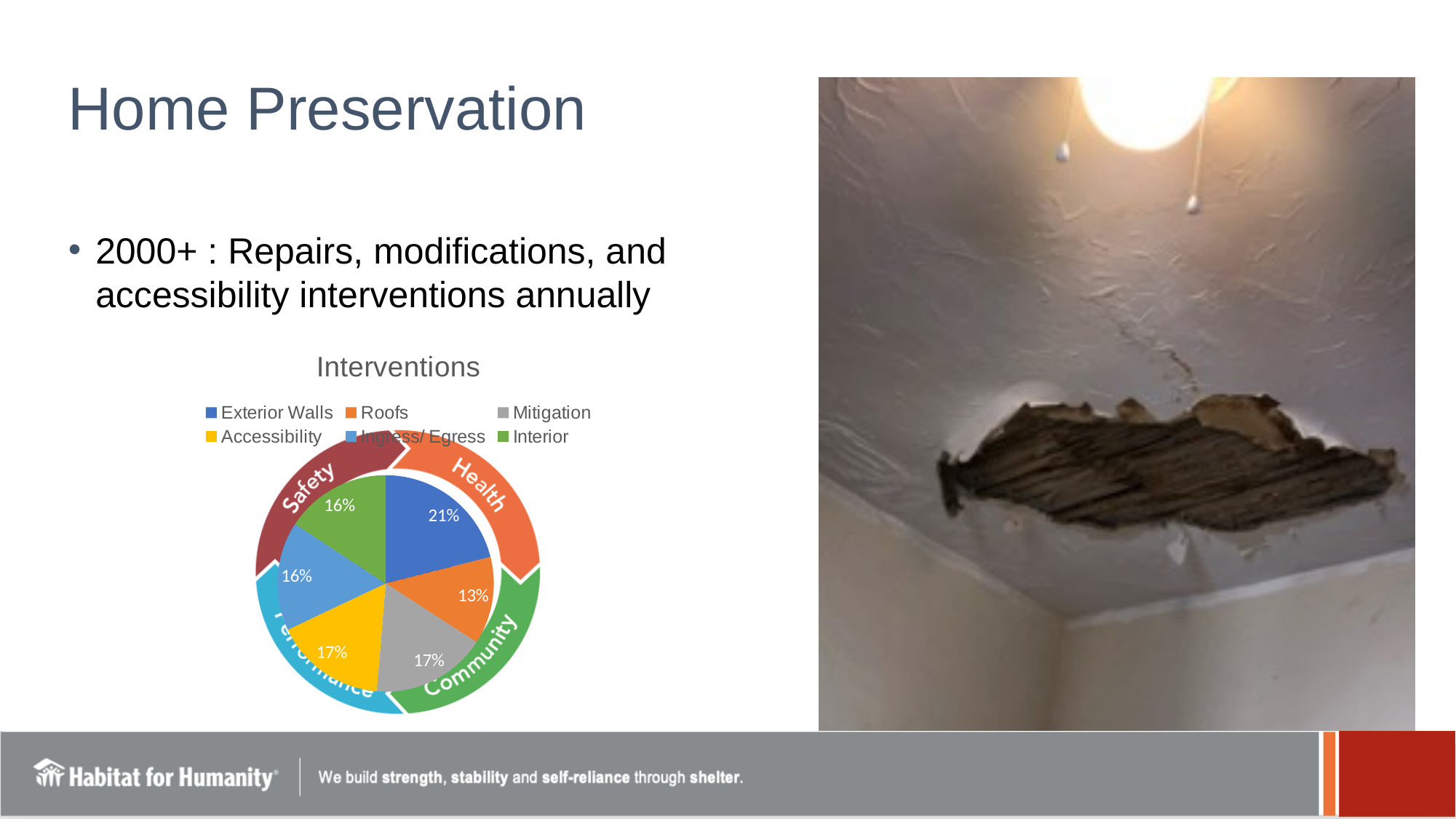
What percentage of the Interventions pie chart is Mitigation? 17% Which category has the largest slice in the Interventions pie chart? Exterior Walls What percentage of the Interventions pie chart is Exterior Walls? 21% What percentage of the Interventions pie chart is Accessibility? 17% What share of the Interventions pie chart does Ingress/Egress represent? 16% How many categories are shown in the Interventions pie chart? 6 What percentage of the Interventions pie chart is Roofs? 13% What share of the Interventions pie chart does Interior represent? 16% In the Interventions pie chart, which is larger: Exterior Walls or Roofs? Exterior Walls What type of chart is used to show the Interventions data? Pie chart Which category has the smallest slice in the Interventions pie chart? Roofs In the Interventions pie chart, how many percentage points larger is Exterior Walls than Roofs? 8 percentage points